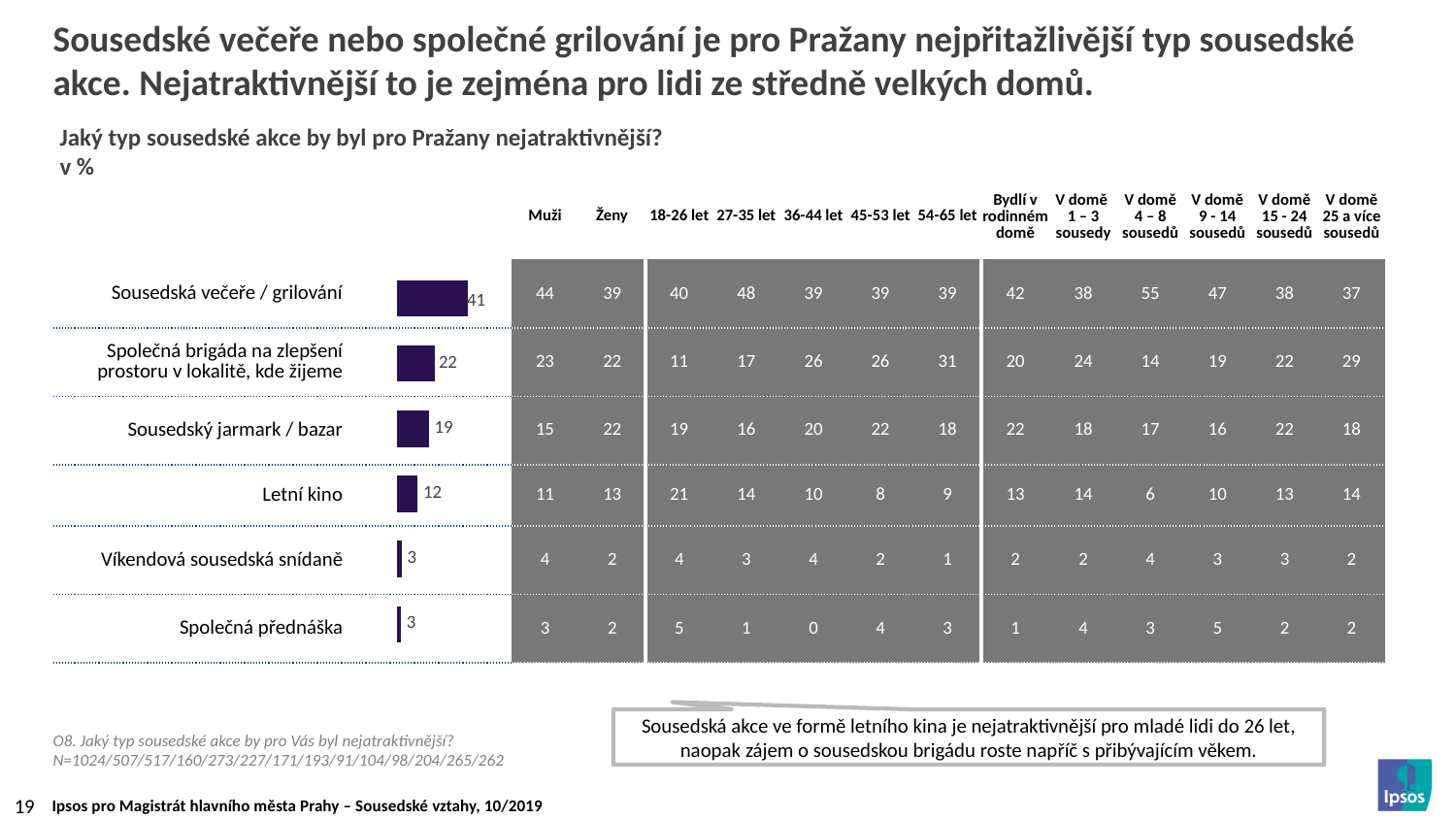
How many categories are shown in the bar chart? 6 What is the value for "Letní kino" in the bar chart? 12 What is the difference between the values for "Sousedský jarmark / bazar" and "Letní kino"? 7 In what unit are the values in the chart expressed, according to the subtitle? % Which is larger in the bar chart: "Společná brigáda na zlepšení prostoru v lokalitě, kde žijeme" or "Sousedský jarmark / bazar"? Společná brigáda na zlepšení prostoru v lokalitě, kde žijeme What is the value for "Sousedská večeře / grilování" in the bar chart? 41 What kind of chart is shown on the slide? bar chart Which category has the highest value in the bar chart? Sousedská večeře / grilování What is the value for "Sousedský jarmark / bazar" in the bar chart? 19 What is the value for "Víkendová sousedská snídaně" in the bar chart? 3 What is the difference between the values for "Sousedská večeře / grilování" and "Společná brigáda na zlepšení prostoru v lokalitě, kde žijeme"? 19 In the table next to the chart, what is the value for "Letní kino" among respondents aged 18-26 let? 21